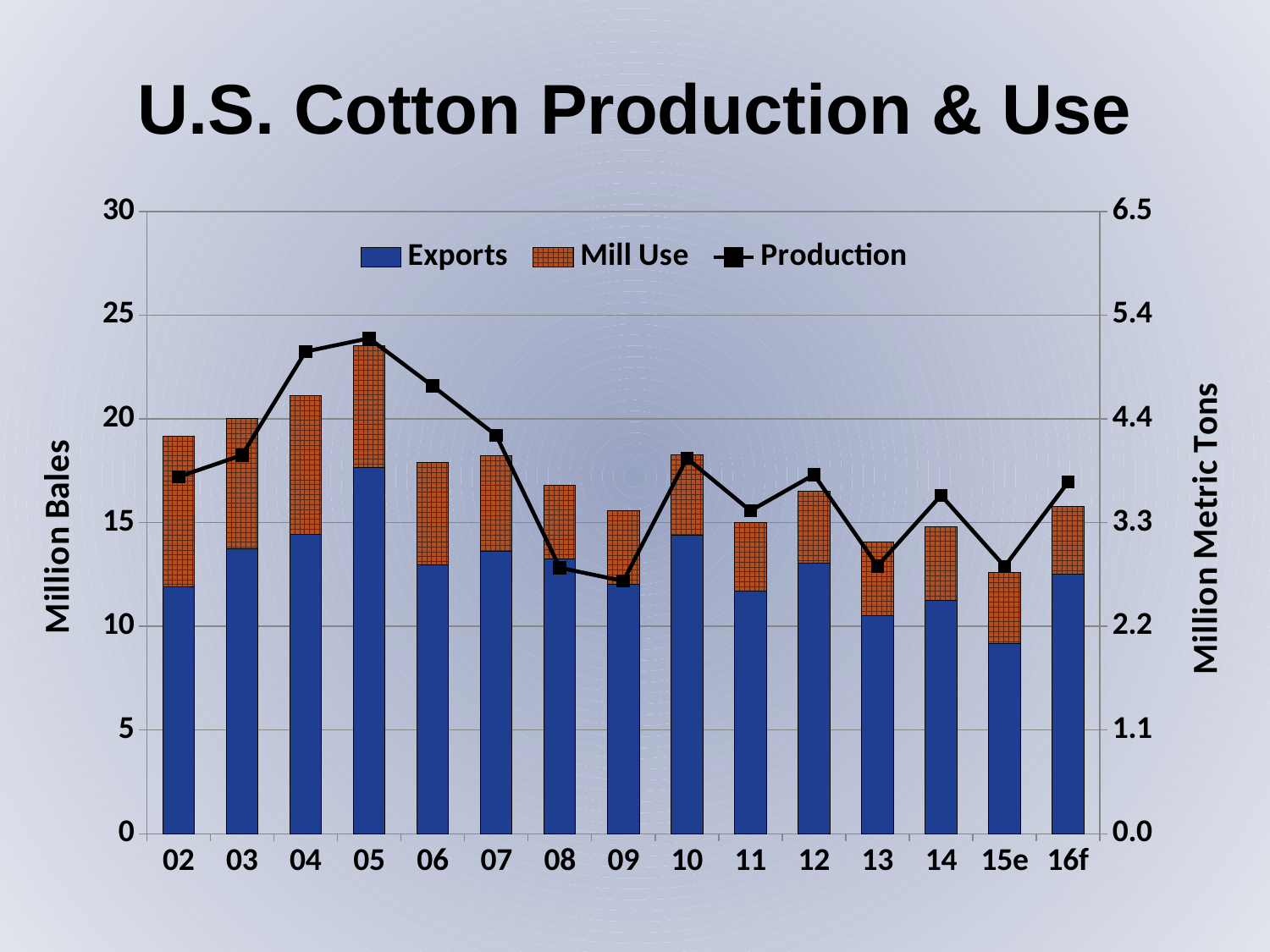
Which year has the shortest stacked bar (Exports plus Mill Use)? 15e What kind of chart is this? Stacked bar chart with a line Which year has the tallest stacked bar (Exports plus Mill Use)? 05 Is the Exports value for 15e greater or less than 10 million bales? less In which year does the Production line reach its highest point? 05 How many series does the legend list? 3 Which year has the lowest Exports value? 15e Which year has the larger total stacked bar, 04 or 06? 04 How many years are shown on the x axis? 15 Is the Exports value for 05 greater or less than 15 million bales? greater Does the Production line rise or fall from 05 to 09? fall Is the Production value for 05 greater or less than 4.4 million metric tons? greater